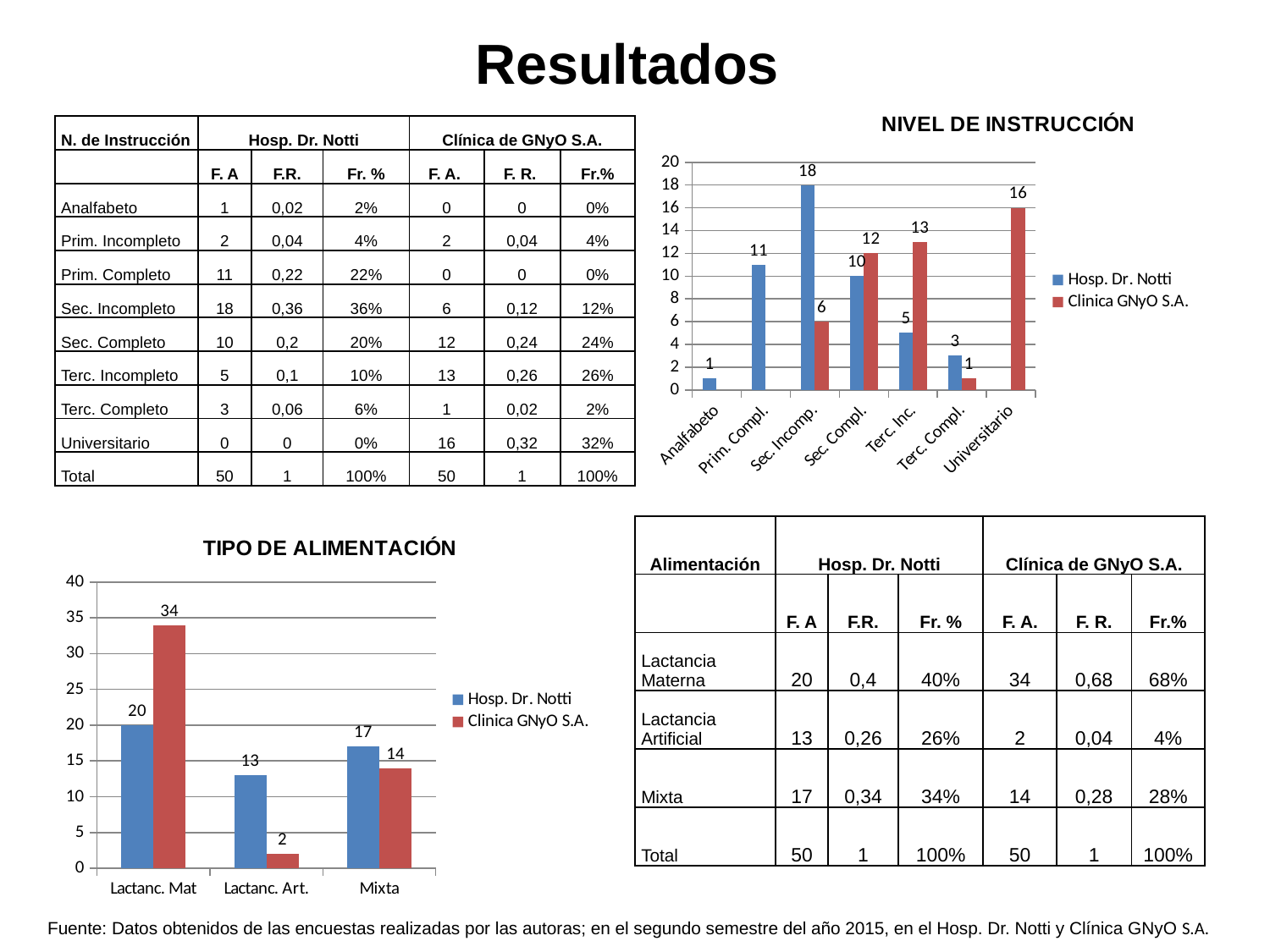
In the NIVEL DE INSTRUCCIÓN chart, which is larger for Sec. Compl.: Hosp. Dr. Notti or Clinica GNyO S.A.? Clinica GNyO S.A. What type of chart is the TIPO DE ALIMENTACIÓN chart? Bar chart In the NIVEL DE INSTRUCCIÓN chart, which category has the highest value for Hosp. Dr. Notti? Sec. Incomp. In the TIPO DE ALIMENTACIÓN chart, which category has the lowest value for Clinica GNyO S.A.? Lactanc. Art. How many categories are shown on the x axis of the NIVEL DE INSTRUCCIÓN chart? 7 In the NIVEL DE INSTRUCCIÓN chart, what is the value for Hosp. Dr. Notti in the Sec. Incomp. category? 18 In the TIPO DE ALIMENTACIÓN chart, which colour represents Hosp. Dr. Notti? Blue How many series does the legend of the NIVEL DE INSTRUCCIÓN chart list? 2 In the NIVEL DE INSTRUCCIÓN chart, what is the value for Clinica GNyO S.A. in the Universitario category? 16 In the TIPO DE ALIMENTACIÓN chart, what is the difference between the Hosp. Dr. Notti and Clinica GNyO S.A. values for Mixta? 3 In the TIPO DE ALIMENTACIÓN chart, what is the value for Clinica GNyO S.A. in the Lactanc. Mat category? 34 In the NIVEL DE INSTRUCCIÓN chart, what is the difference between the Clinica GNyO S.A. and Hosp. Dr. Notti values for Terc. Inc.? 8